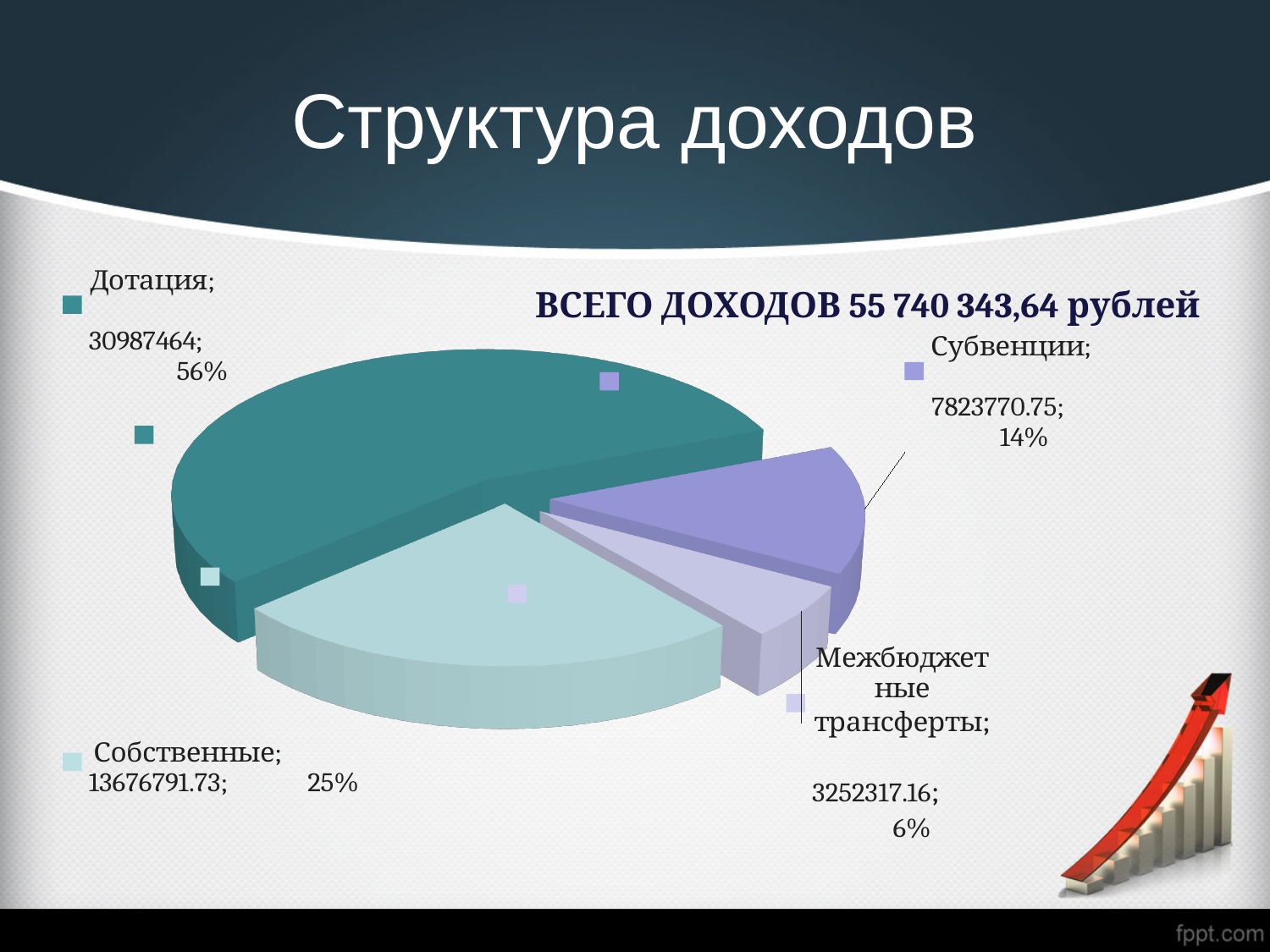
What percentage share does Дотация have in the pie chart? 56% What is the value shown for Дотация? 30987464 Which is larger, Собственные or Субвенции? Собственные What percentage share does Собственные have in the pie chart? 25% How many slices does the pie chart have? 4 Which category has the smallest slice in the pie chart? Межбюджетные трансферты What percentage share does Субвенции have in the pie chart? 14% What total income is stated on the slide? 55 740 343,64 рублей Which category has the largest slice in the pie chart? Дотация What is the value shown for Субвенции? 7823770.75 What kind of chart is shown on the slide? pie chart What is the value shown for Межбюджетные трансферты? 3252317.16